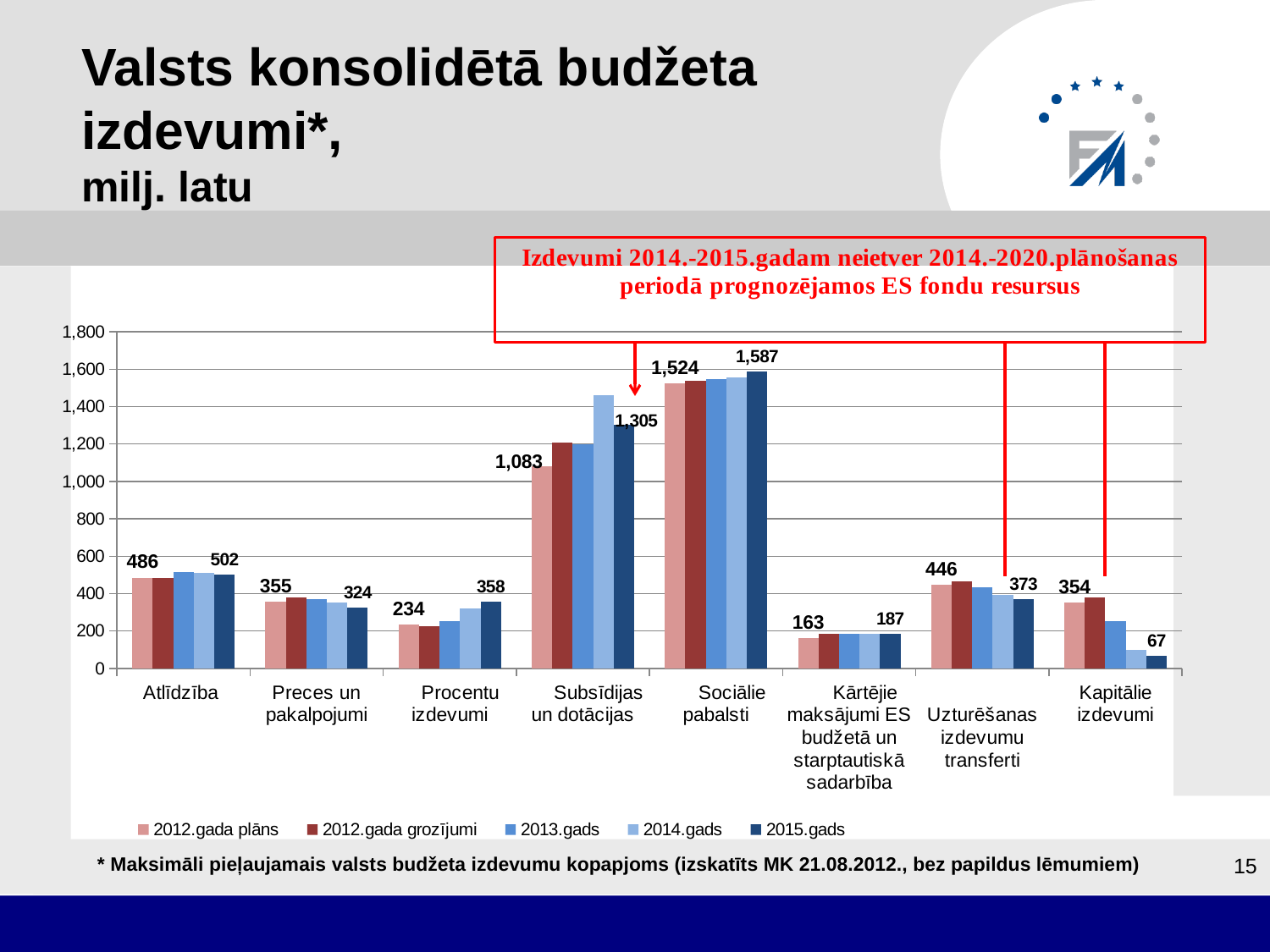
What is the value for 2012.gada plāns in the Subsīdijas un dotācijas category? 1,083 Which category has the highest value for 2015.gads? Sociālie pabalsti What kind of chart is shown on the slide? Bar chart Is the 2014.gads value for Subsīdijas un dotācijas greater or less than 1,400? greater What is the value for 2015.gads in the Kapitālie izdevumi category? 67 Which is larger for Uzturēšanas izdevumu transferti: the 2012.gada plāns value or the 2015.gads value? 2012.gada plāns What is the difference between the 2015.gads value and the 2012.gada plāns value for Procentu izdevumi? 124 What is the value for 2012.gada plāns in the Atlīdzība category? 486 How many series does the legend list? 5 Which category has the lowest value for 2015.gads? Kapitālie izdevumi How many categories are shown on the x axis? 8 What is the value for 2015.gads in the Sociālie pabalsti category? 1,587